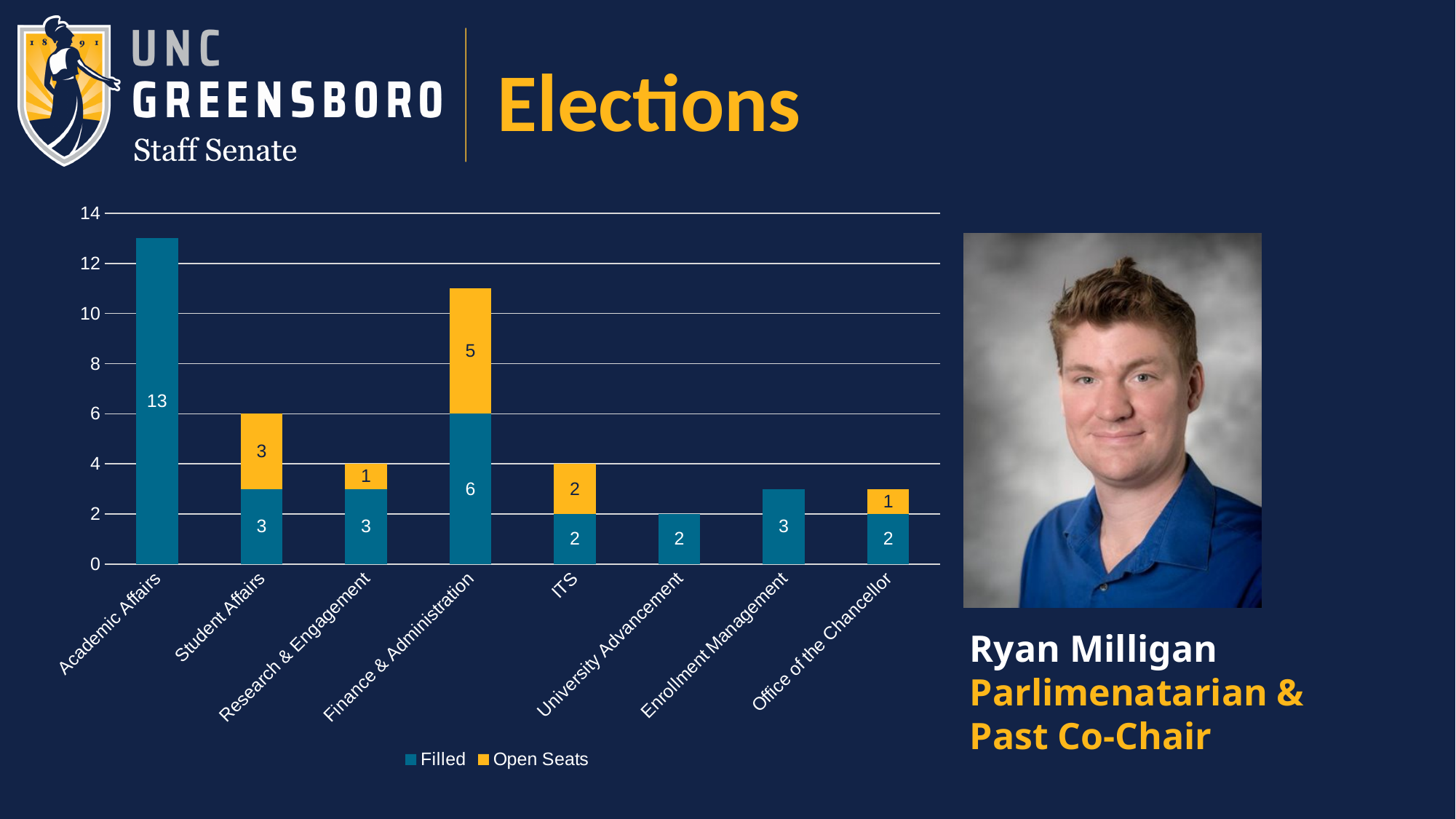
How many series does the legend list? 2 Which category has the highest Filled value? Academic Affairs What is the difference between the Filled values for Academic Affairs and Finance & Administration? 7 Which category has the highest Open Seats value? Finance & Administration What kind of chart is shown on the slide? Stacked bar chart How many categories are shown on the x axis? 8 What is the Filled value for Enrollment Management? 3 Which is larger, the Open Seats value for ITS or the Open Seats value for Research & Engagement? ITS What is the Filled value for Academic Affairs? 13 What is the total of the stacked bar for Student Affairs? 6 What is the total of the stacked bar for Finance & Administration? 11 What is the Open Seats value for Finance & Administration? 5